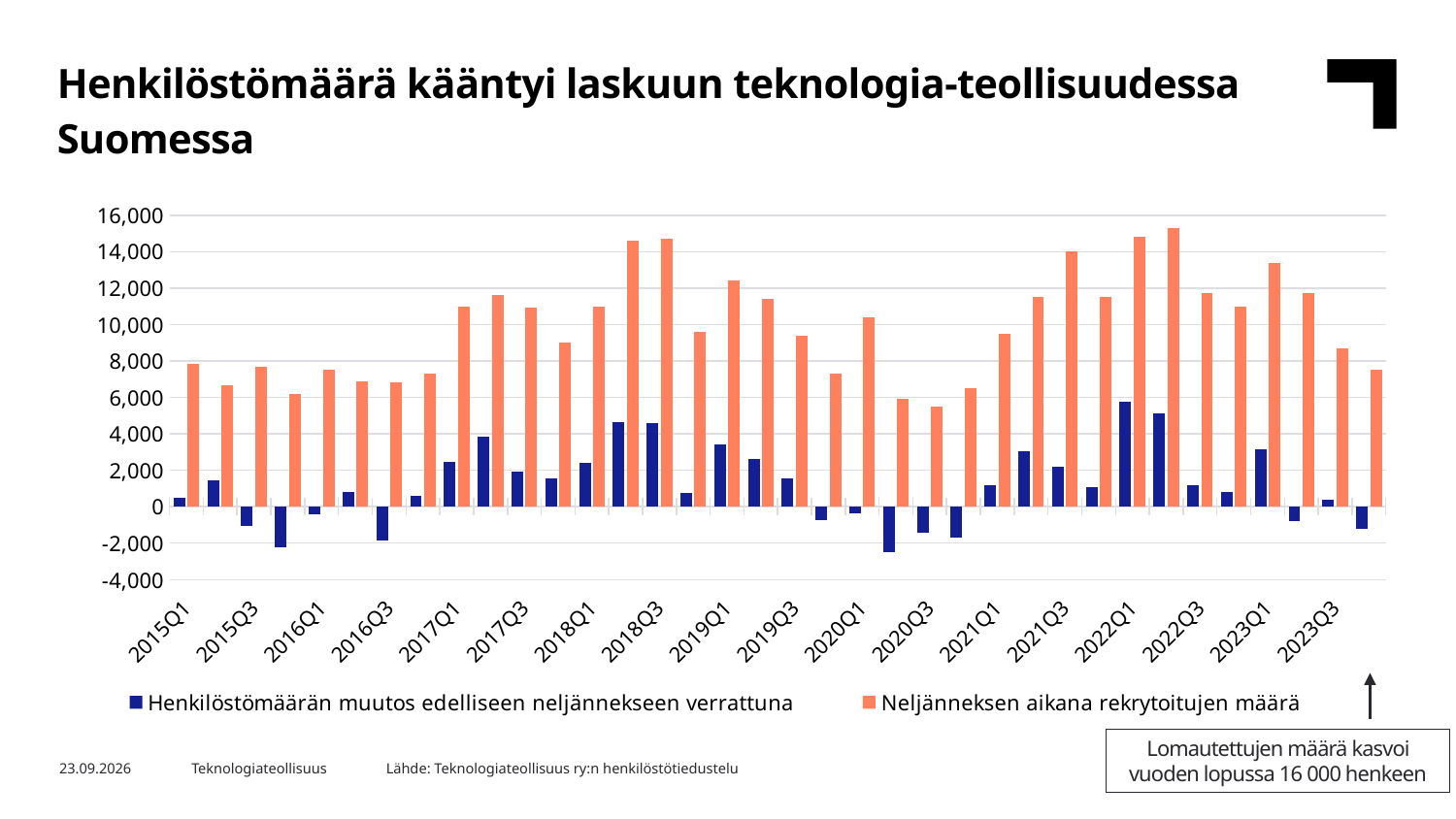
Is the value for Neljänneksen aikana rekrytoitujen määrä in 2018Q3 greater or less than 14,000? greater Which is larger for Neljänneksen aikana rekrytoitujen määrä: 2018Q3 or 2015Q1? 2018Q3 Which quarter has the highest value for Henkilöstömäärän muutos edelliseen neljännekseen verrattuna? 2022Q1 Is the value for Henkilöstömäärän muutos edelliseen neljännekseen verrattuna in 2020Q2 greater or less than -2,000? less Does the value for Neljänneksen aikana rekrytoitujen määrä rise or fall from 2020Q3 to 2022Q2? rise What kind of chart is shown on the slide? bar chart Which quarter has the highest value for Neljänneksen aikana rekrytoitujen määrä? 2022Q2 How many quarters are plotted on the x axis, from 2015Q1 to 2023Q4? 36 Is the value for Neljänneksen aikana rekrytoitujen määrä in 2020Q3 greater or less than 6,000? less Which series is shown in orange in the legend? Neljänneksen aikana rekrytoitujen määrä How many series does the legend list? 2